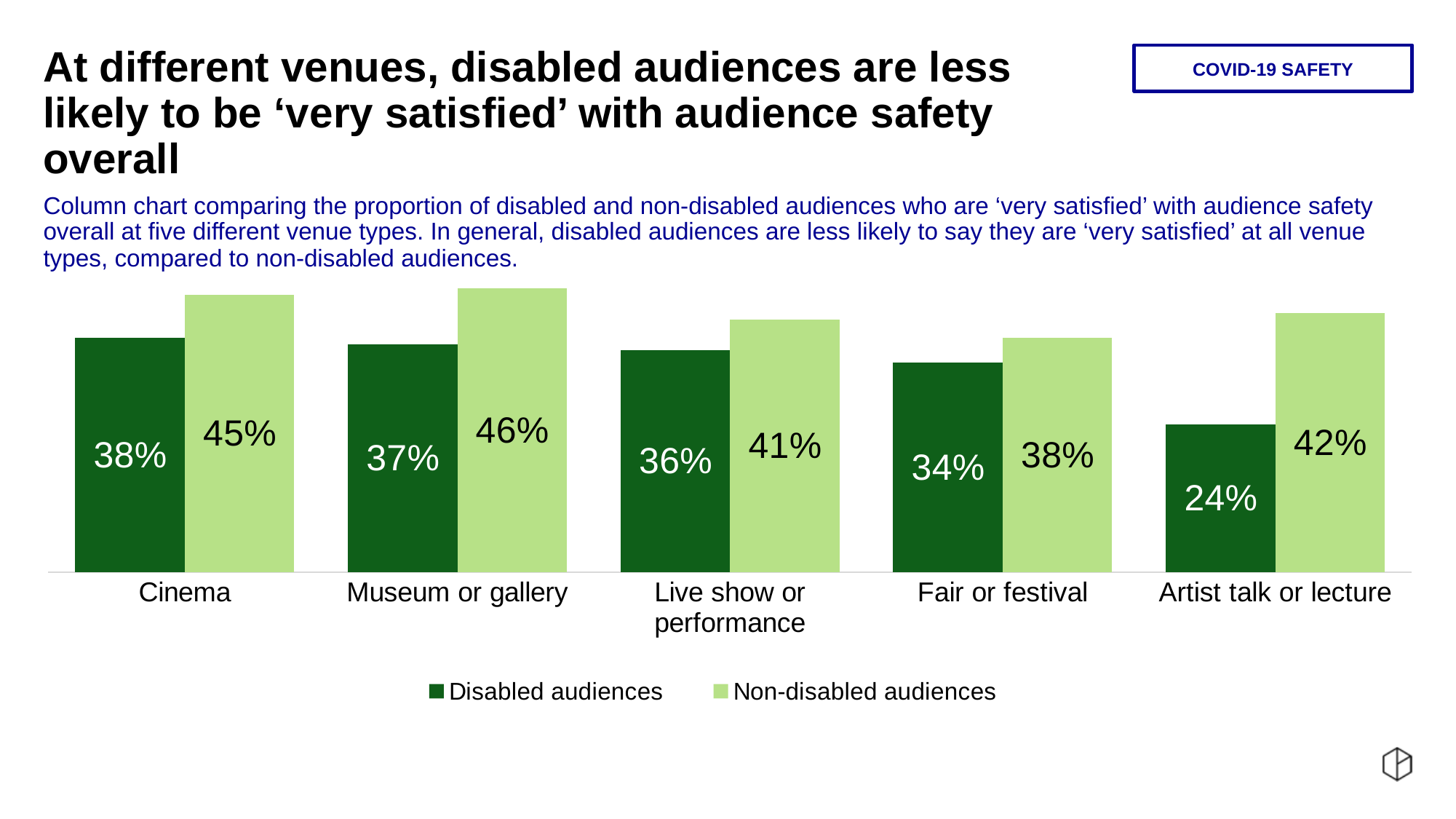
What is the value for non-disabled audiences at museum or gallery? 46% What is the difference between non-disabled and disabled audiences at fair or festival? 4 percentage points What is the value for non-disabled audiences at live show or performance? 41% What is the difference between non-disabled and disabled audiences at artist talk or lecture? 18 percentage points What percentage of disabled audiences are 'very satisfied' with audience safety at the cinema? 38% What kind of chart is shown on the slide? Bar chart Which is larger at the cinema: the value for disabled audiences or for non-disabled audiences? Non-disabled audiences How many venue types are shown on the chart? 5 Which venue type has the lowest value for disabled audiences? Artist talk or lecture How many series does the legend list? 2 What is the value for disabled audiences at artist talk or lecture? 24% Which venue type has the highest value for non-disabled audiences? Museum or gallery